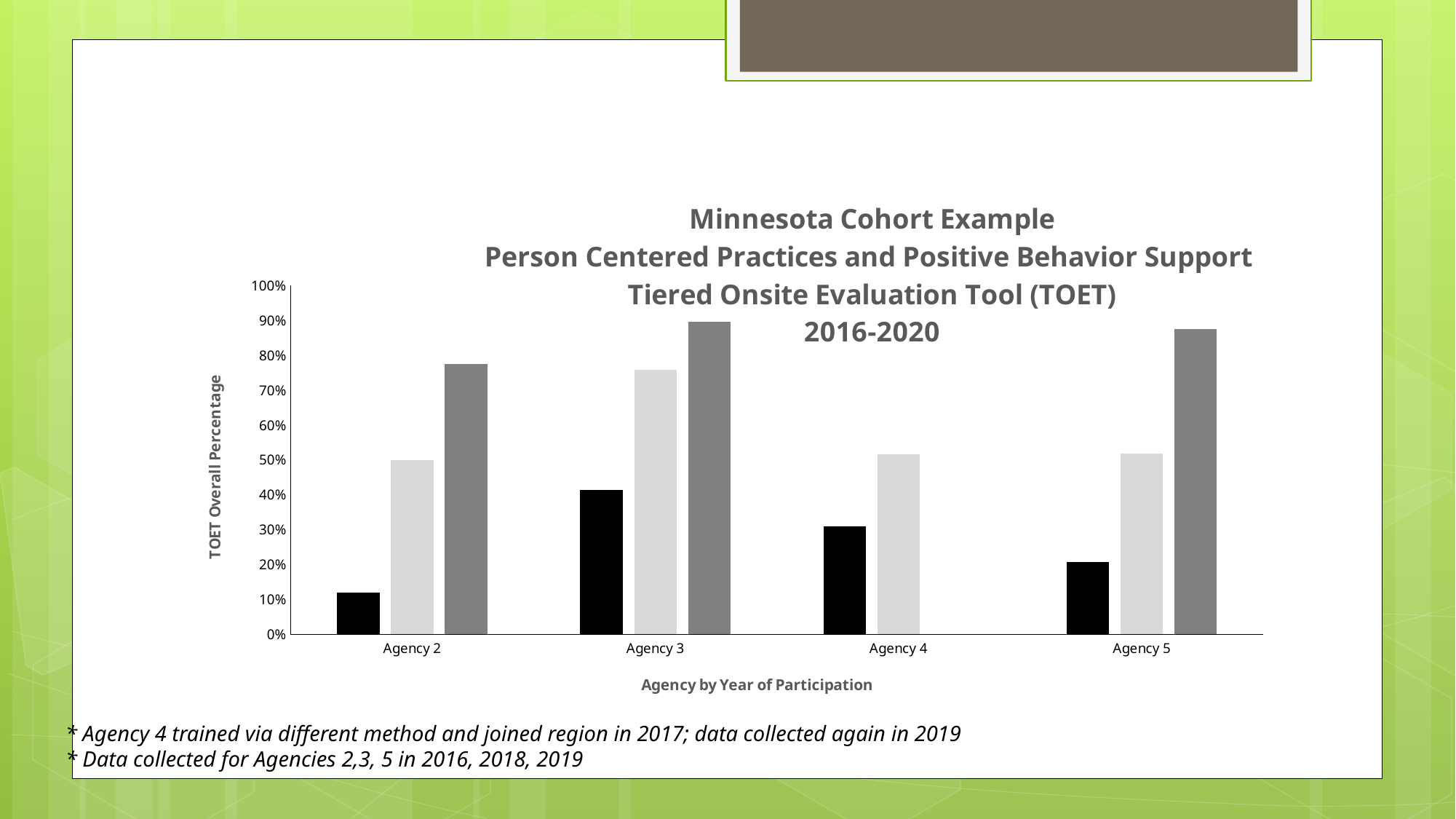
Is the light gray bar for Agency 3 greater or less than 70%? greater Which agency has the lowest black bar? Agency 2 How many agencies are shown on the x axis of the chart? 4 Which agency has no dark gray bar? Agency 4 What is the label on the vertical axis of the chart? TOET Overall Percentage Is the dark gray bar for Agency 3 greater or less than 80%? greater What kind of chart is shown on the slide? bar chart Is the black bar for Agency 4 greater or less than 40%? less Which is larger, the light gray bar for Agency 3 or the light gray bar for Agency 5? Agency 3 Which agency has the highest black bar? Agency 3